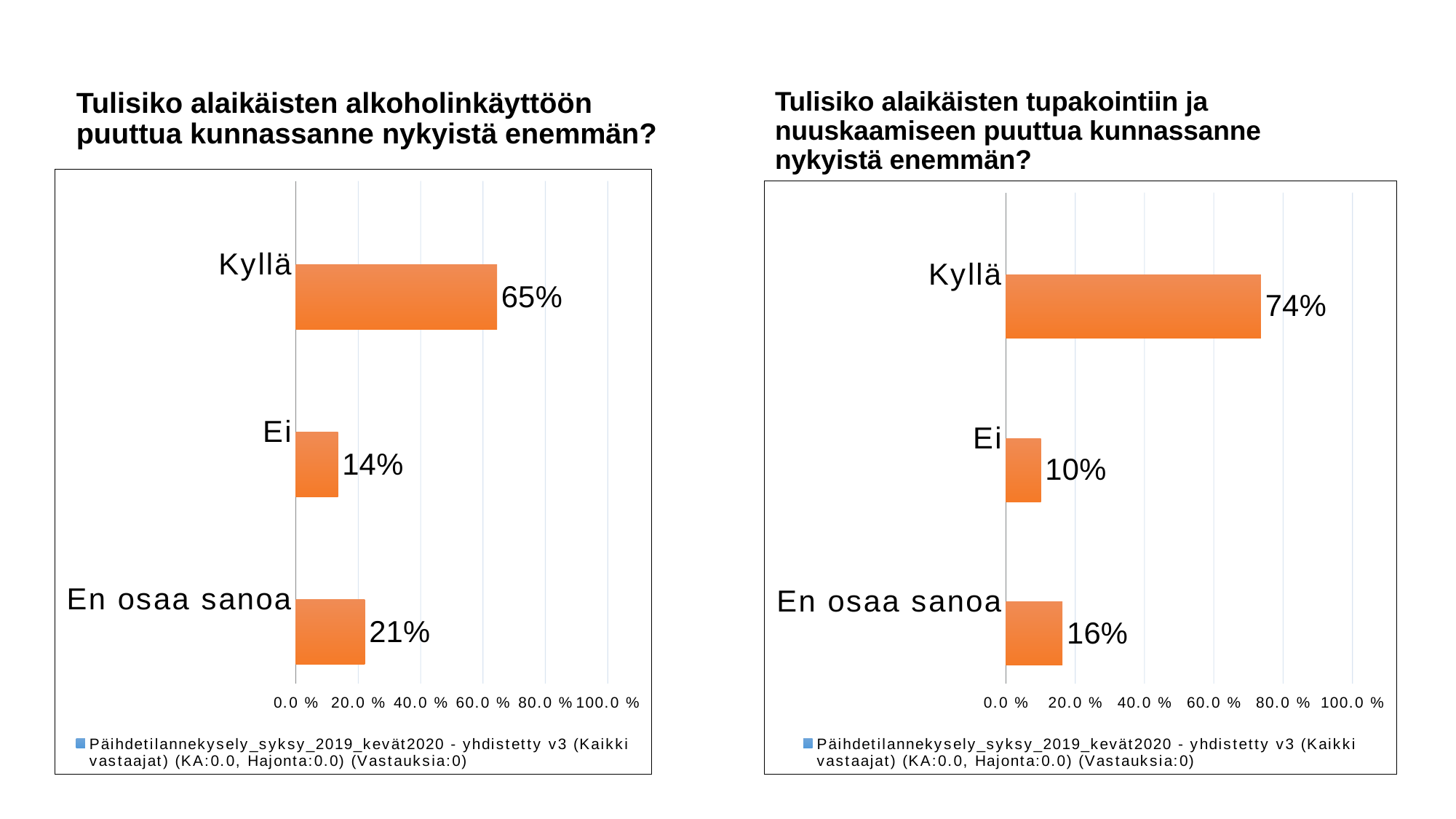
In the right chart (smoking and snus), what is the difference between En osaa sanoa and Ei? 6% In the right chart (smoking and snus), what is the value for Kyllä? 74% In the left chart (alcohol use), what is the value for En osaa sanoa? 21% In the right chart (smoking and snus), which category has the highest value? Kyllä In the left chart (alcohol use), what is the difference between Kyllä and En osaa sanoa? 44% Which chart has the larger value for Kyllä, the left chart (alcohol use) or the right chart (smoking and snus)? the right chart In the left chart (alcohol use), which category has the lowest value? Ei In the left chart (alcohol use), what is the value for Kyllä? 65% In the right chart (smoking and snus), what is the value for Ei? 10% In the left chart (alcohol use), is the value for Kyllä greater or less than 60.0 %? greater What kind of chart is the left chart (alcohol use)? bar chart How many categories does the right chart (smoking and snus) show? 3